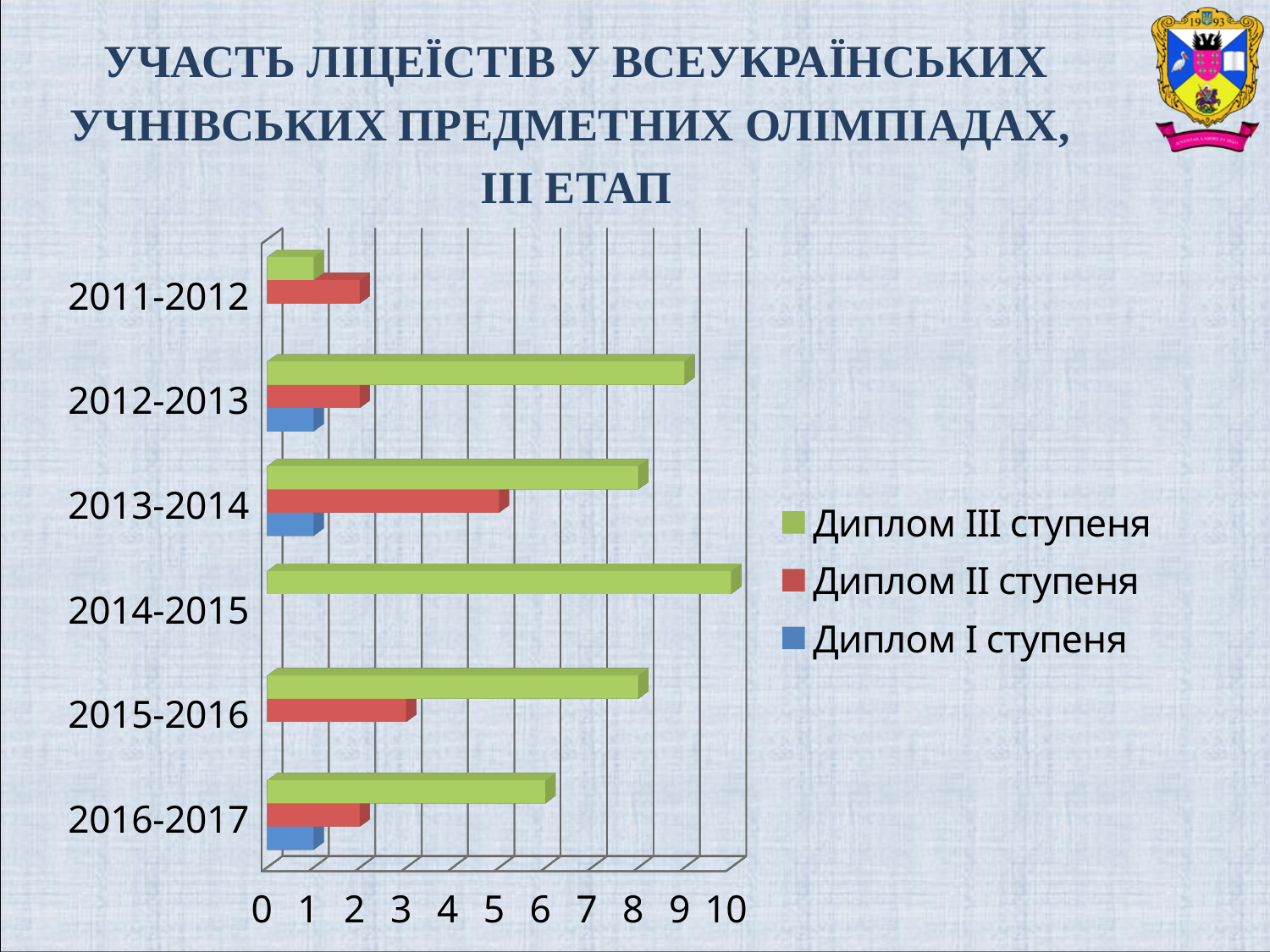
Which academic year has the highest value for Диплом II ступеня? 2013-2014 Is the value for Диплом III ступеня in 2016-2017 greater or less than 8? less Which colour represents Диплом I ступеня in the legend? Blue Which academic year has the lowest value for Диплом III ступеня? 2011-2012 How many academic-year categories are shown on the chart? 6 Which series is listed first in the legend? Диплом III ступеня Is the value for Диплом III ступеня in 2014-2015 greater or less than 8? greater Which academic year has the highest value for Диплом III ступеня? 2014-2015 What kind of chart is shown on the slide? Bar chart Is the value for Диплом II ступеня in 2013-2014 greater or less than 4? greater How many series does the legend list? 3 Which is larger: the Диплом II ступеня value for 2013-2014 or for 2015-2016? 2013-2014